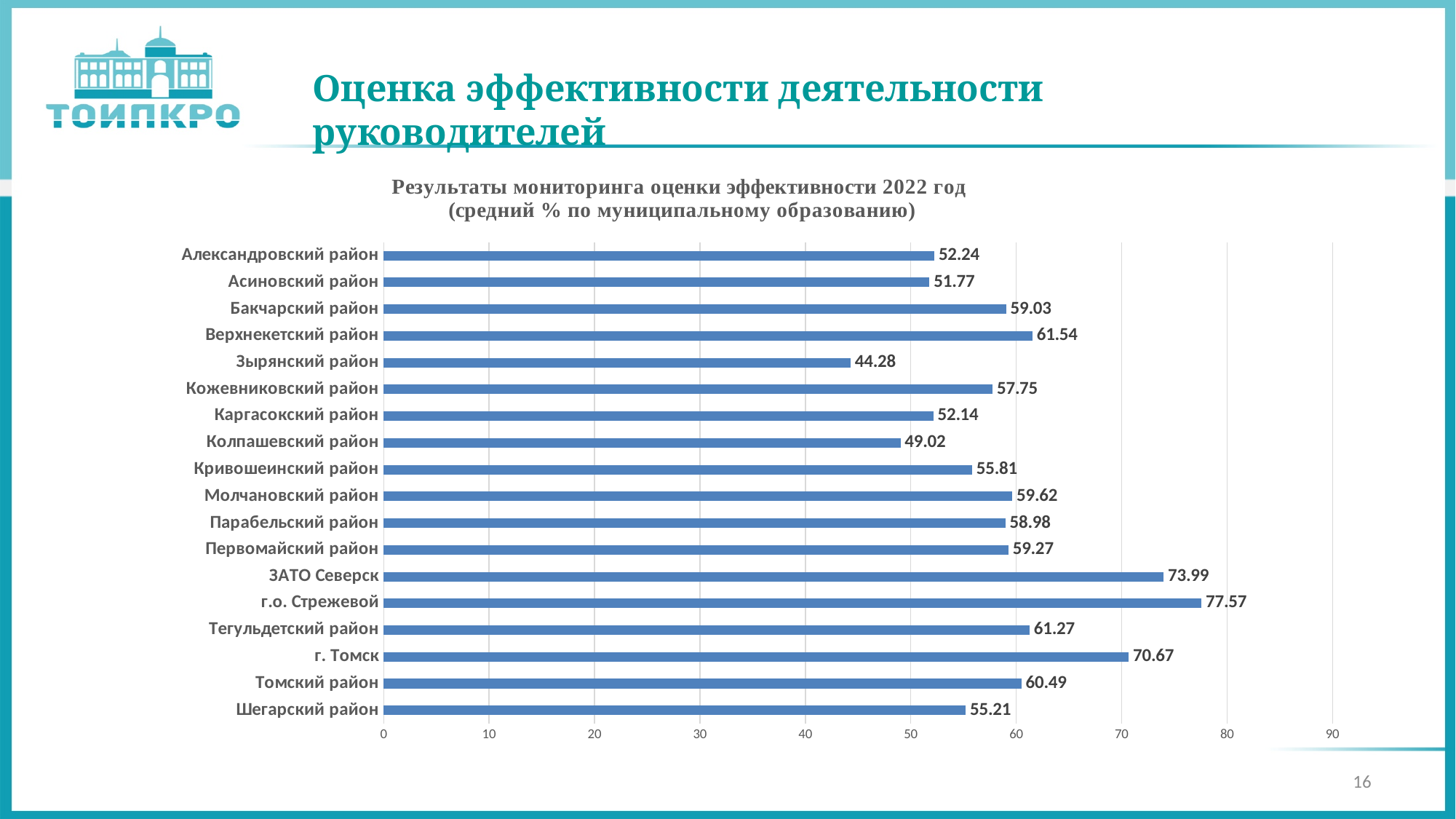
What is the value for Томский район? 60.49 How many categories are shown in the chart? 18 What is the value for Колпашевский район? 49.02 Which category has the highest value? г.о. Стрежевой What kind of chart is shown on the slide? bar chart What is the difference between the values for г. Томск and Томский район? 10.18 Is the value for Зырянский район greater or less than 50? less What year is named in the chart title? 2022 Which has a larger value, Колпашевский район or Кривошеинский район? Кривошеинский район Which category has the lowest value? Зырянский район What is the value for ЗАТО Северск? 73.99 What is the difference between the values for г.о. Стрежевой and ЗАТО Северск? 3.58